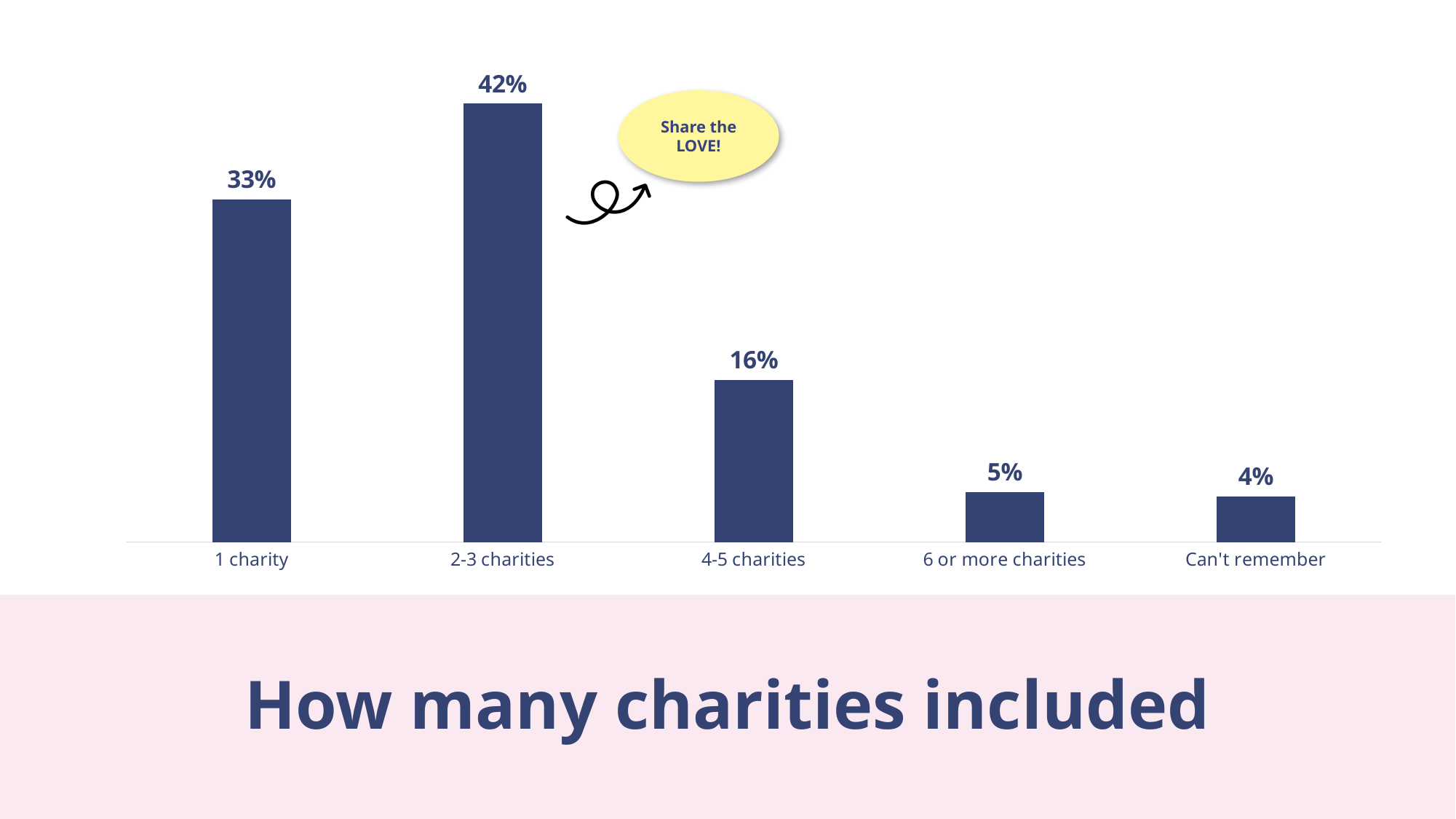
What percentage of respondents included 1 charity? 33% What is the value for 6 or more charities? 5% What is the value shown for 2-3 charities? 42% What is the difference between the values for 2-3 charities and 1 charity? 9% How many categories are shown on the x axis? 5 What percentage is shown for 4-5 charities? 16% What percentage of respondents can't remember how many charities they included? 4% Which category has the lowest value? Can't remember Which category has the highest value? 2-3 charities What is the title of the chart? How many charities included What kind of chart is shown on the slide? Bar chart Which is larger, the value for 1 charity or the value for 4-5 charities? 1 charity